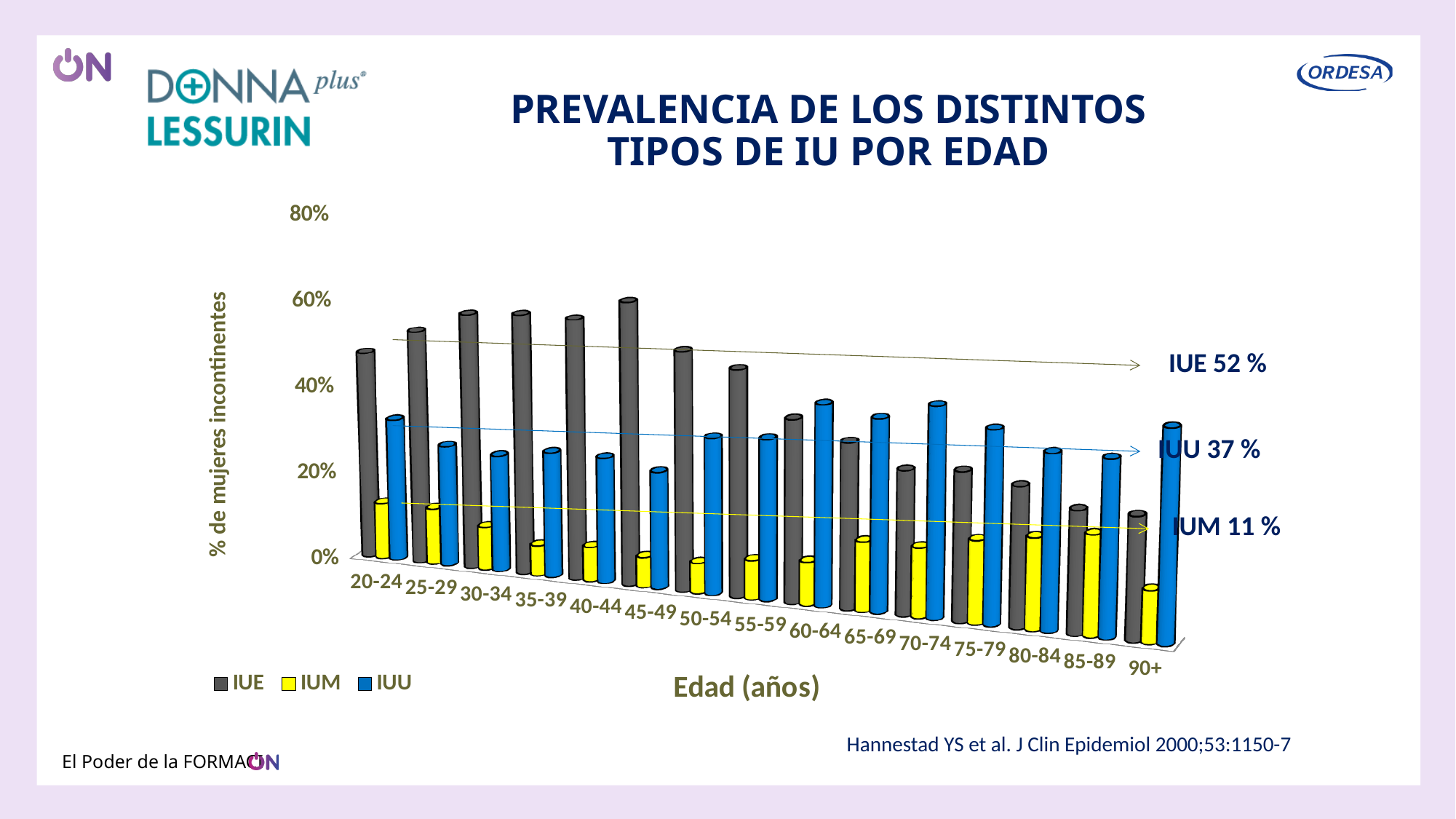
How many age groups are shown on the x axis of the chart? 15 What overall percentage is annotated for IUU on the chart? 37 % What are the three series listed in the chart legend? IUE, IUM, IUU In the 20-24 age group, which is larger, IUE or IUU? IUE Do the IUE values generally rise or fall as age increases from 45-49 to 90+? fall Is the IUE value for the 45-49 age group greater or less than 40%? greater What overall percentage is annotated for IUE on the chart? 52 % What is the label of the x axis of the chart? Edad (años) What overall percentage is annotated for IUM on the chart? 11 % What kind of chart is shown on the slide? bar chart How many series does the chart legend list? 3